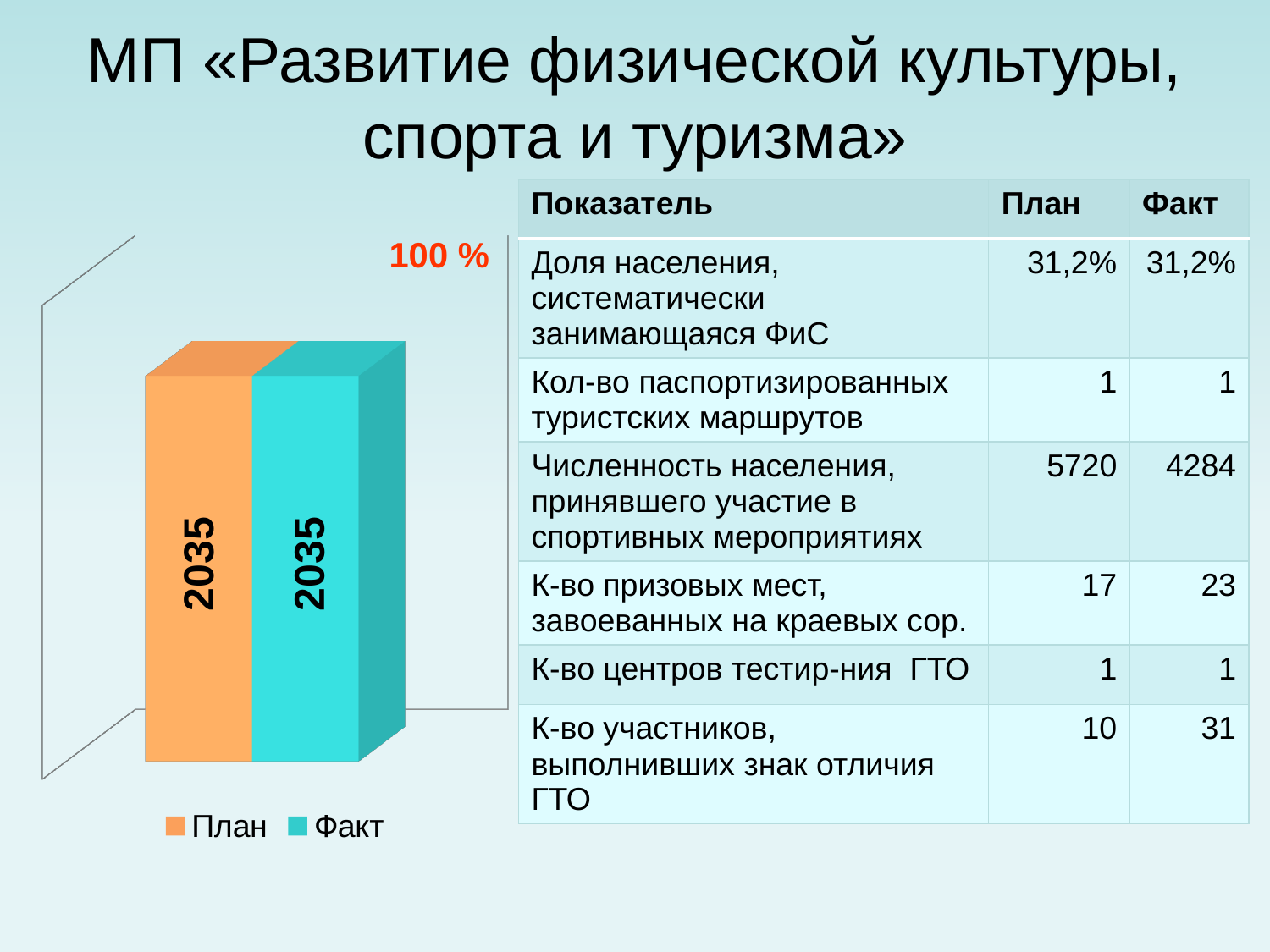
Which colour represents the Факт series in the chart? turquoise How many series does the chart legend list? 2 How many bars are plotted in the chart? 2 What is the difference between the План and Факт values in the chart? 0 What value is printed on the План bar in the chart? 2035 What are the two series named in the chart legend? План and Факт Is the Факт bar in the chart taller than the План bar, or are they the same height? the same height What value is printed on the Факт bar in the chart? 2035 What kind of chart is shown on the left of the slide? bar chart What percentage label is printed above the chart? 100 %